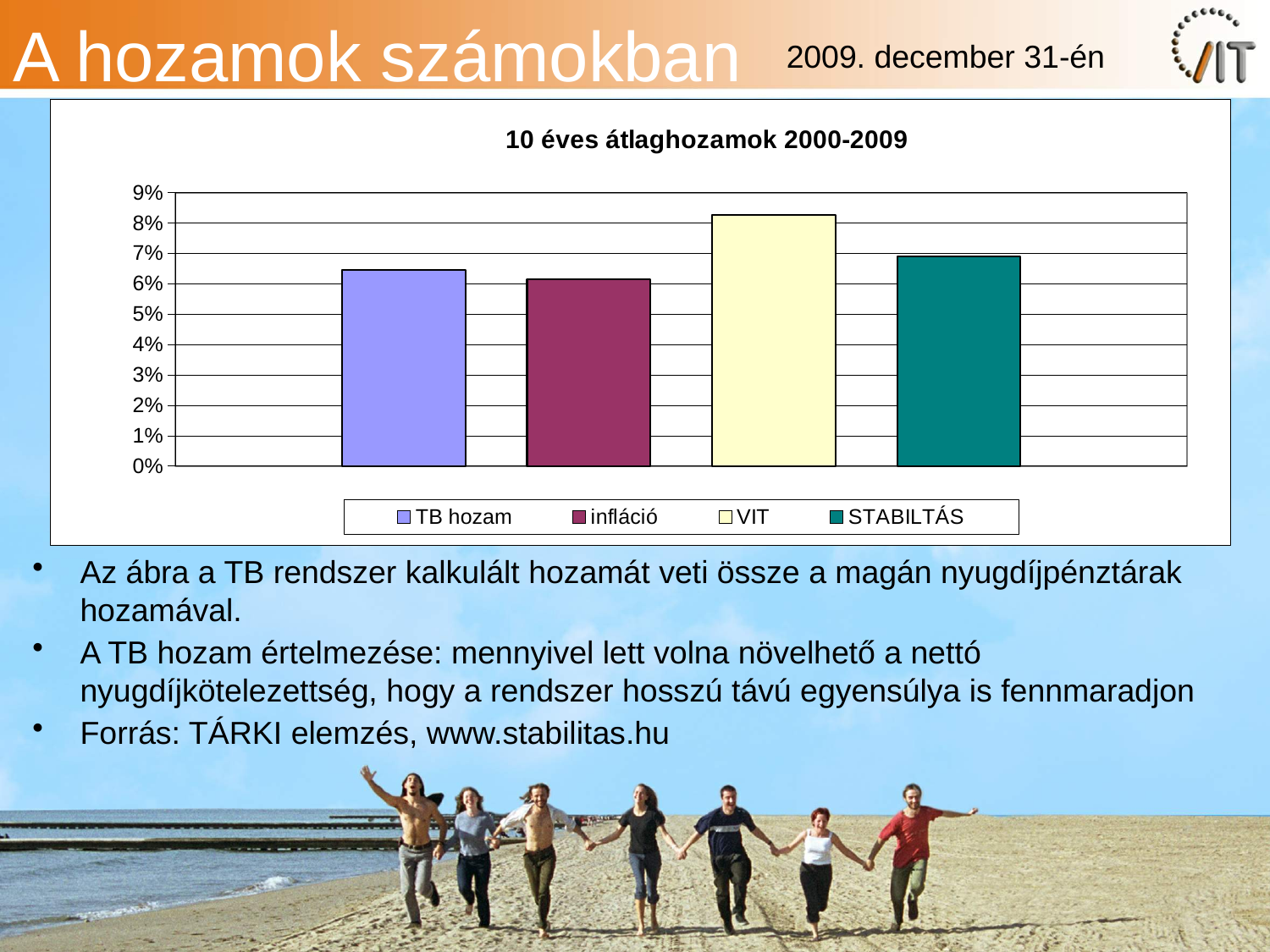
How many series does the chart legend list? 4 Is the value for VIT greater or less than 8%? greater Is the value for TB hozam greater or less than 6%? greater Which is larger, the value for STABILTÁS or the value for infláció? STABILTÁS Is the value for infláció greater or less than 7%? less How many bars are plotted in the chart? 4 Which series has the highest value in the chart? VIT What kind of chart is shown on the slide? bar chart What is the title of the chart? 10 éves átlaghozamok 2000-2009 Which is larger, the value for VIT or the value for STABILTÁS? VIT